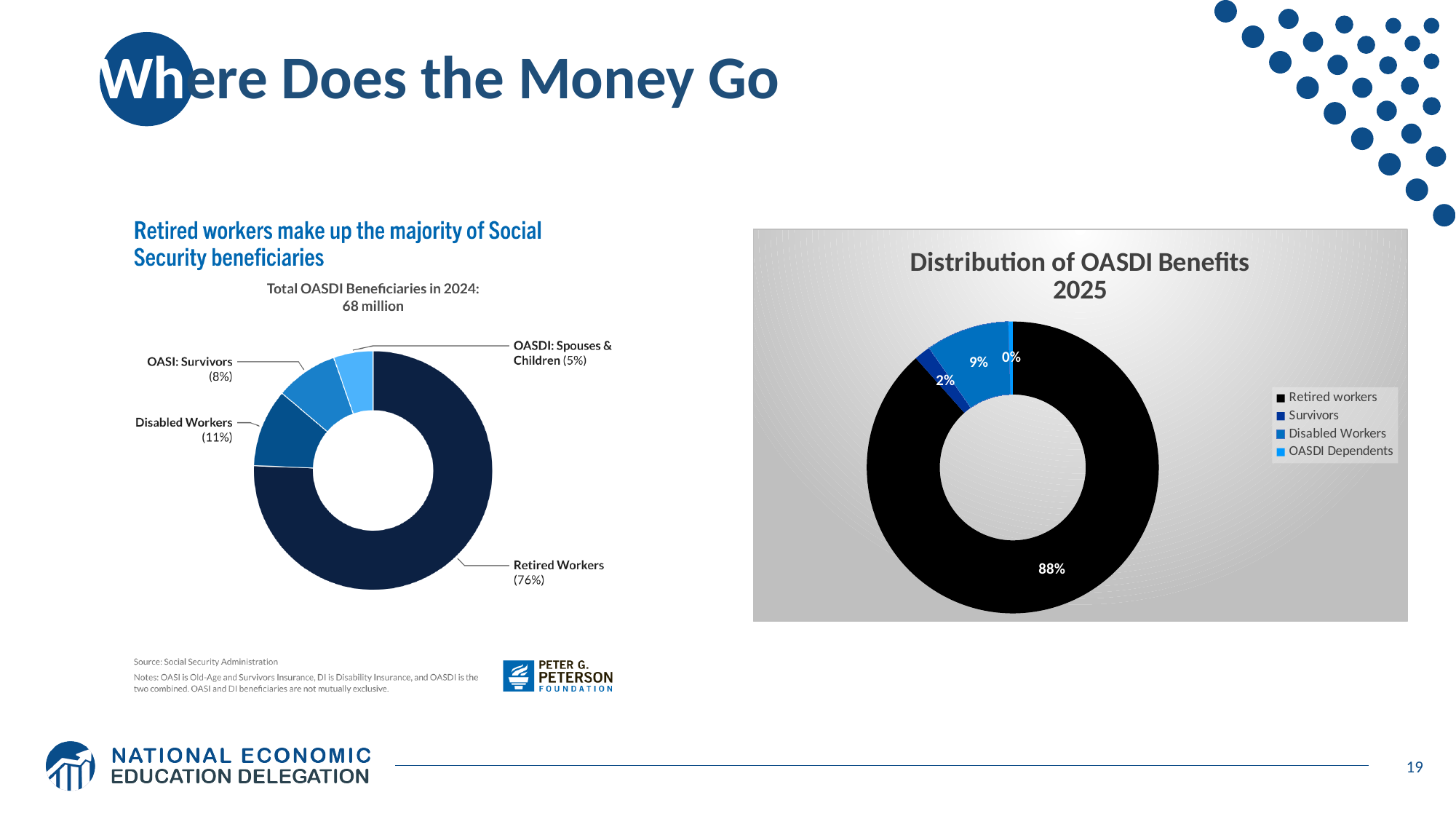
In the 'Total OASDI Beneficiaries in 2024' chart on the left, which is larger: the share for OASI: Survivors or the share for OASDI: Spouses & Children? OASI: Survivors In the 'Total OASDI Beneficiaries in 2024' chart on the left, what percentage are OASI: Survivors? 8% In the 'Total OASDI Beneficiaries in 2024' chart on the left, what is the difference in percentage points between Retired Workers and Disabled Workers? 65 percentage points According to the title of the left chart, what is the total number of OASDI beneficiaries in 2024? 68 million In the 'Distribution of OASDI Benefits 2025' chart, which category has the smallest share? OASDI Dependents What kind of chart is the 'Distribution of OASDI Benefits 2025' chart? Donut (pie) chart In the 'Distribution of OASDI Benefits 2025' chart, what share of benefits goes to Survivors? 2% In the 'Total OASDI Beneficiaries in 2024' chart on the left, what percentage of beneficiaries are Disabled Workers? 11% In the 'Total OASDI Beneficiaries in 2024' chart on the left, what percentage of beneficiaries are Retired Workers? 76% In the 'Distribution of OASDI Benefits 2025' chart, what share of benefits goes to Retired workers? 88% In the 'Distribution of OASDI Benefits 2025' chart, what share of benefits goes to Disabled Workers? 9% How many categories does the legend of the 'Distribution of OASDI Benefits 2025' chart list? 4